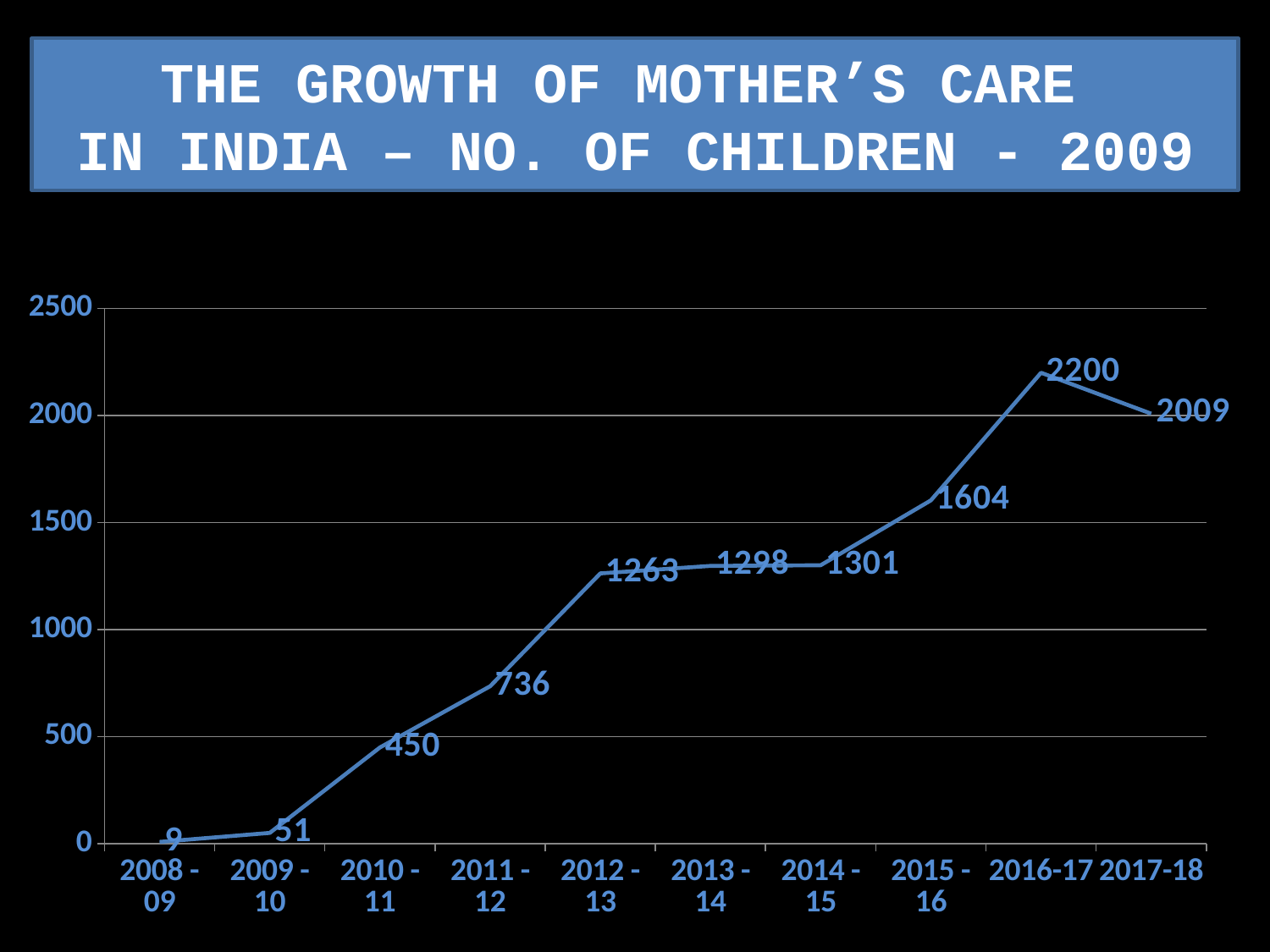
What is the number of children for 2011-12? 736 What is the number of children for 2016-17? 2200 Which is larger, the value for 2015-16 or the value for 2013-14? 2015-16 How many years are plotted on the chart? 10 What is the difference between the values for 2010-11 and 2009-10? 399 What is the number of children for 2008-09? 9 Which year has the lowest number of children? 2008-09 Does the number of children rise or fall from 2008-09 to 2016-17? rise What is the number of children for 2014-15? 1301 Which year has the highest number of children? 2016-17 What is the difference between the values for 2016-17 and 2017-18? 191 What kind of chart is shown on the slide? line chart